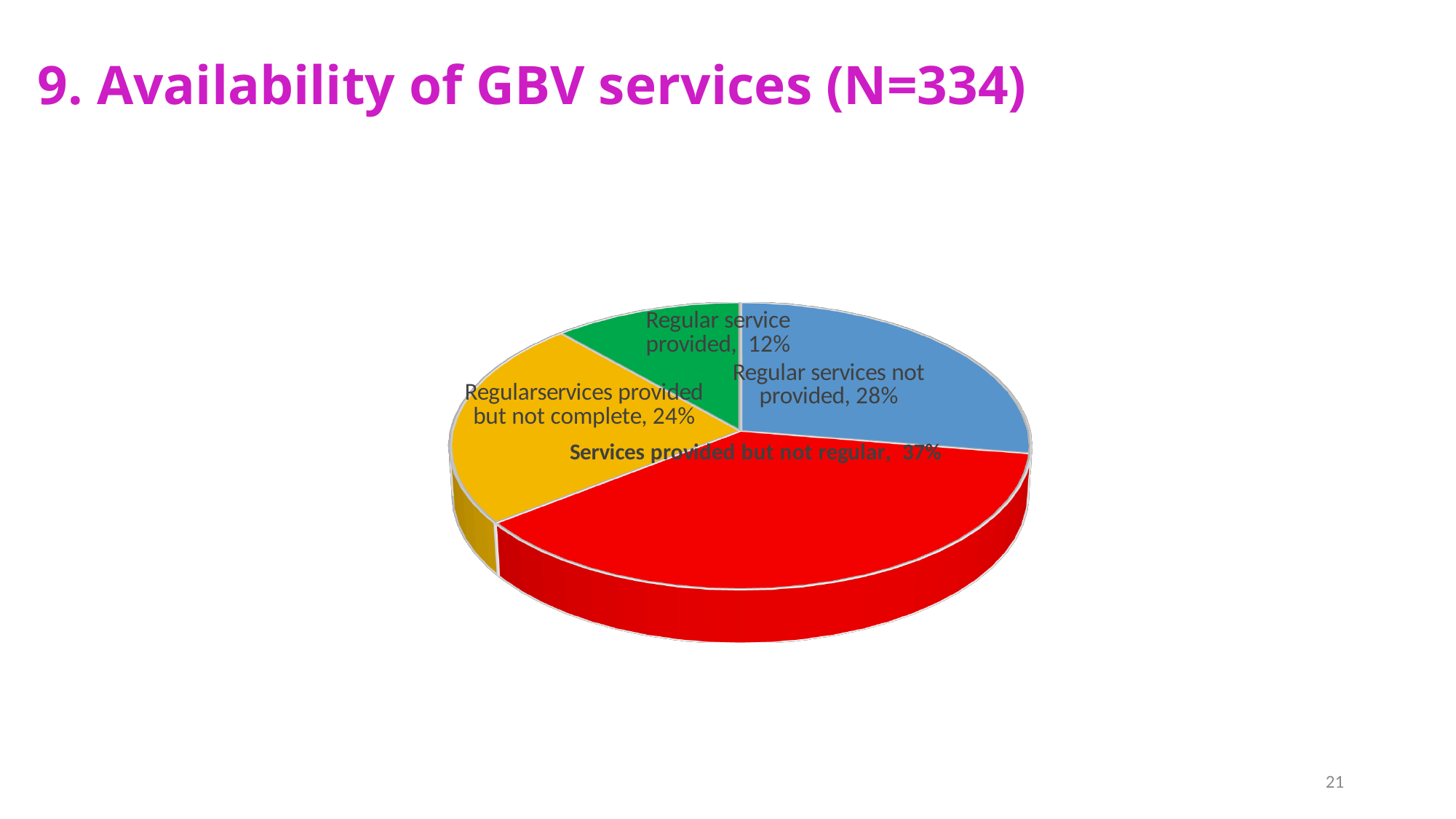
What percentage of the pie is 'Regular services not provided'? 28% What kind of chart is shown on the slide? Pie chart Which category has the smallest share of the pie? Regular service provided Which is larger: 'Regular services not provided' or 'Regularservices provided but not complete'? Regular services not provided What colour is the slice for 'Services provided but not regular'? Red What percentage of the pie is 'Regular service provided'? 12% What is the difference in percentage points between 'Services provided but not regular' and 'Regular services not provided'? 9 What percentage of the pie is 'Regularservices provided but not complete'? 24% How many slices does the pie chart have? 4 What percentage of the pie is 'Services provided but not regular'? 37% What is the title of the slide? 9. Availability of GBV services (N=334) Which category has the largest share of the pie? Services provided but not regular